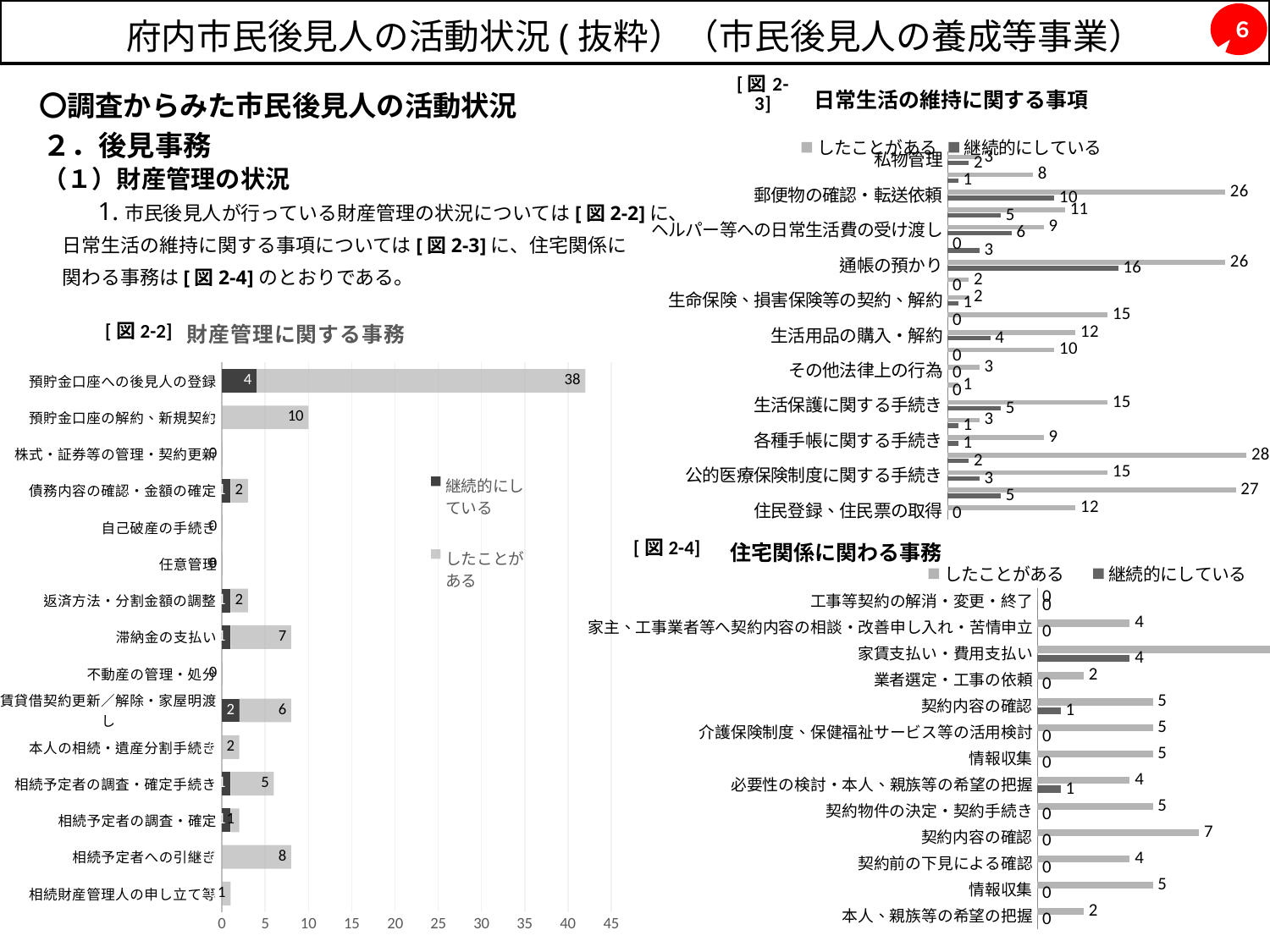
In the chart titled 財産管理に関する事務, which has the larger したことがある value: 滞納金の支払い or 相続予定者への引継ぎ? 相続予定者への引継ぎ In the chart titled 財産管理に関する事務, what is the 継続的にしている value for 預貯金口座への後見人の登録? 4 In the chart titled 財産管理に関する事務, what is the したことがある value for 預貯金口座への後見人の登録? 38 In the chart titled 日常生活の維持に関する事項, what is the したことがある value for 通帳の預かり? 26 In the chart titled 財産管理に関する事務, which category has the highest したことがある value? 預貯金口座への後見人の登録 How many series does the legend of the chart titled 財産管理に関する事務 list? 2 In the chart titled 住宅関係に関わる事務, what is the したことがある value for 契約前の下見による確認? 4 In the chart titled 財産管理に関する事務, what is the difference between the したことがある and 継続的にしている values for 預貯金口座への後見人の登録? 34 What kind of chart is the chart titled 財産管理に関する事務? Bar chart In the chart titled 財産管理に関する事務, what is the したことがある value for 相続予定者への引継ぎ? 8 In the chart titled 住宅関係に関わる事務, which category has the longest したことがある bar? 家賃支払い・費用支払い In the chart titled 日常生活の維持に関する事項, what is the difference between the したことがある and 継続的にしている values for 通帳の預かり? 10